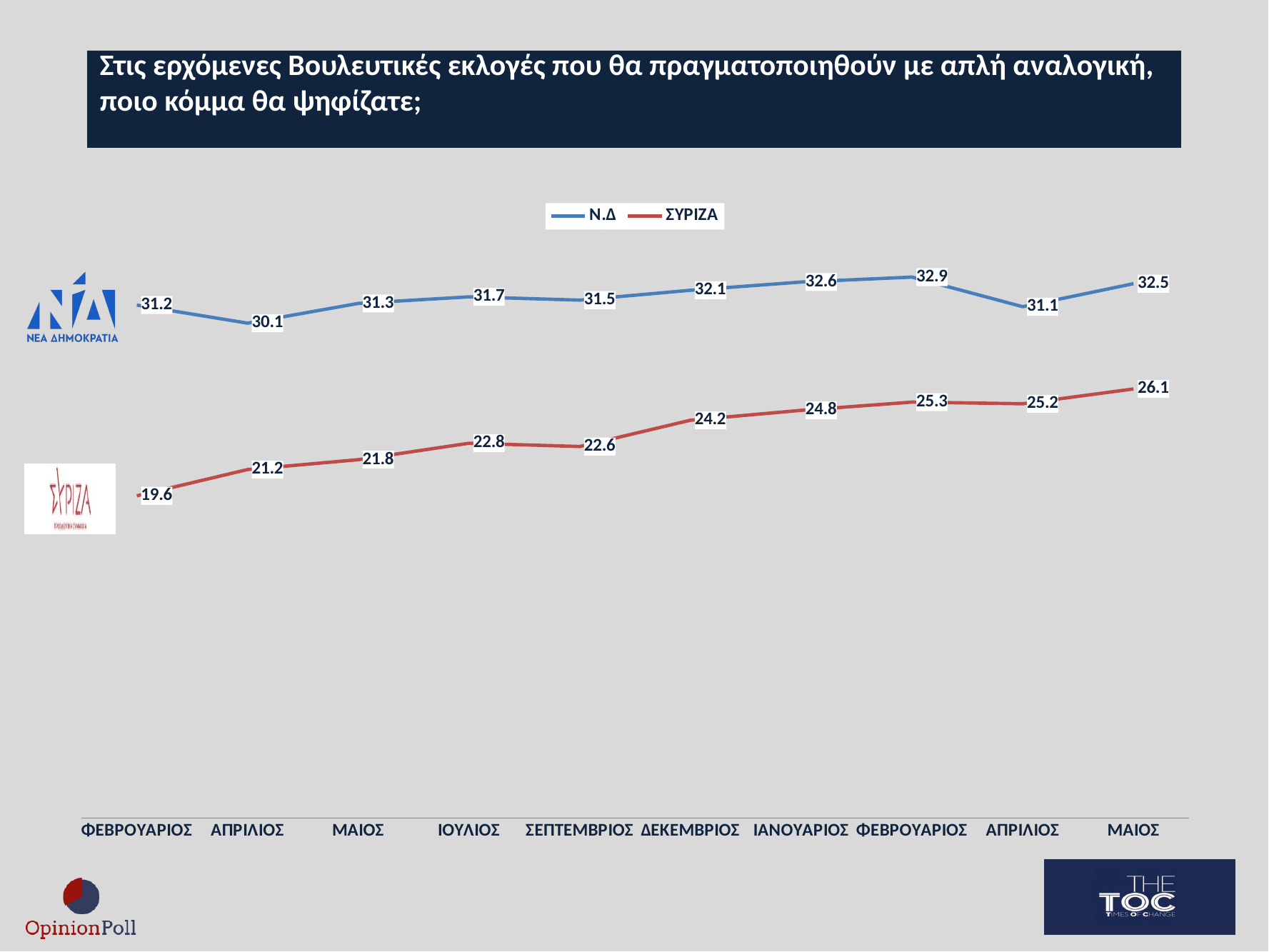
What kind of chart is shown on the slide? Line chart What is the lowest value shown for ΣΥΡΙΖΑ? 19.6 What is the value for Ν.Δ at ΙΟΥΛΙΟΣ? 31.7 What is the difference between Ν.Δ and ΣΥΡΙΖΑ at ΙΟΥΛΙΟΣ? 8.9 How many data points does each line have? 10 What is the lowest value shown for Ν.Δ? 30.1 What is the value for ΣΥΡΙΖΑ at the last ΜΑΙΟΣ point on the x axis? 26.1 What is the value for ΣΥΡΙΖΑ at ΔΕΚΕΜΒΡΙΟΣ? 24.2 Which series has the higher value at ΙΑΝΟΥΑΡΙΟΣ, Ν.Δ or ΣΥΡΙΖΑ? Ν.Δ What is the difference between Ν.Δ and ΣΥΡΙΖΑ at ΔΕΚΕΜΒΡΙΟΣ? 7.9 How many series does the legend list? 2 At which x-axis point does Ν.Δ reach its highest value? The second ΦΕΒΡΟΥΑΡΙΟΣ (32.9)